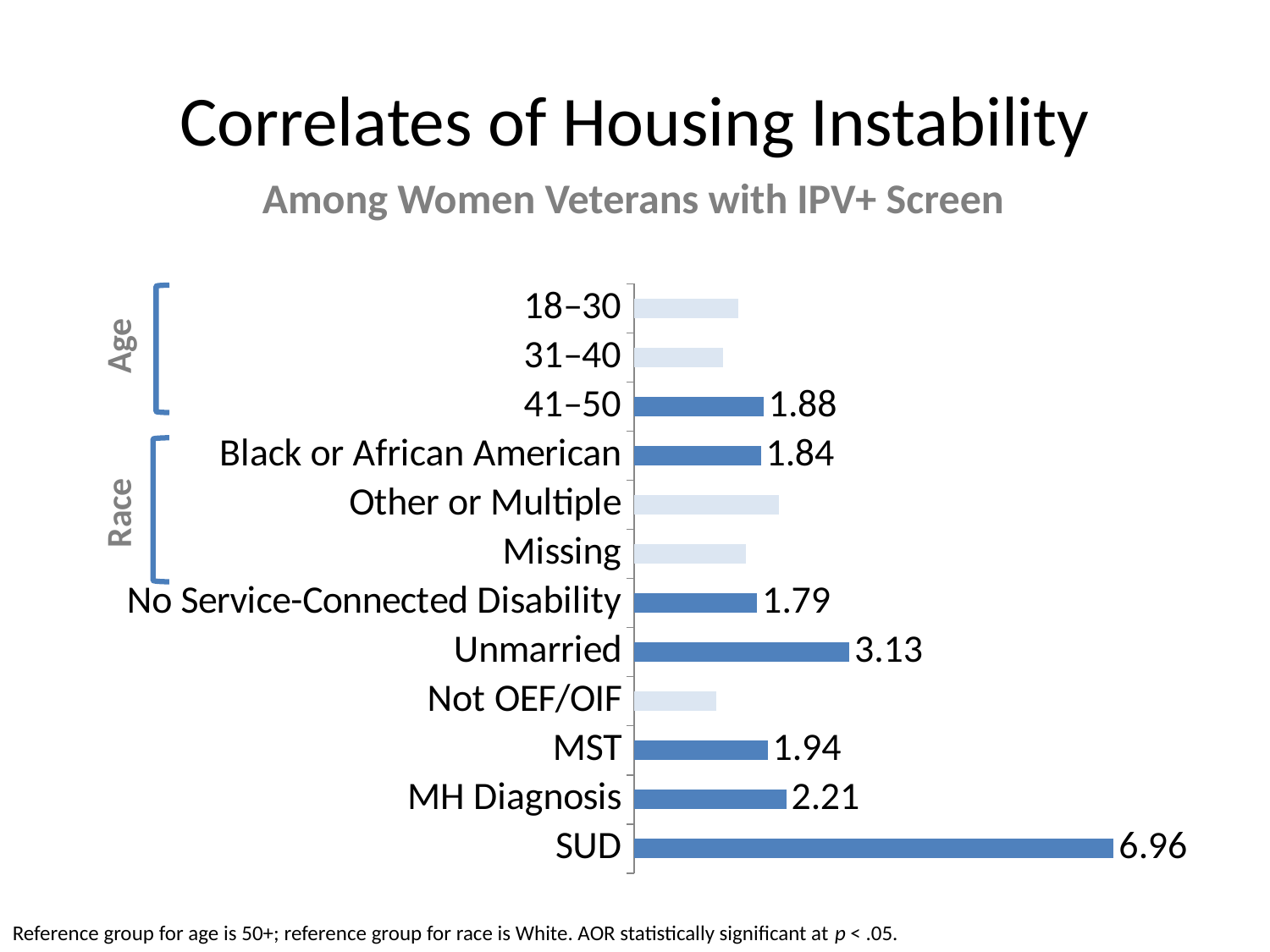
Which is larger, the value for Unmarried or the value for MH Diagnosis? Unmarried What is the title of the chart? Correlates of Housing Instability What is the value for MH Diagnosis? 2.21 Which category has the highest value? SUD What is the value for SUD? 6.96 What is the value for No Service-Connected Disability? 1.79 What is the value for the 41–50 age group? 1.88 What kind of chart is shown on the slide? Bar chart What is the difference between the values for MH Diagnosis and MST? 0.27 What is the difference between the values for SUD and Unmarried? 3.83 What is the value for Unmarried? 3.13 How many categories are shown in the chart? 12